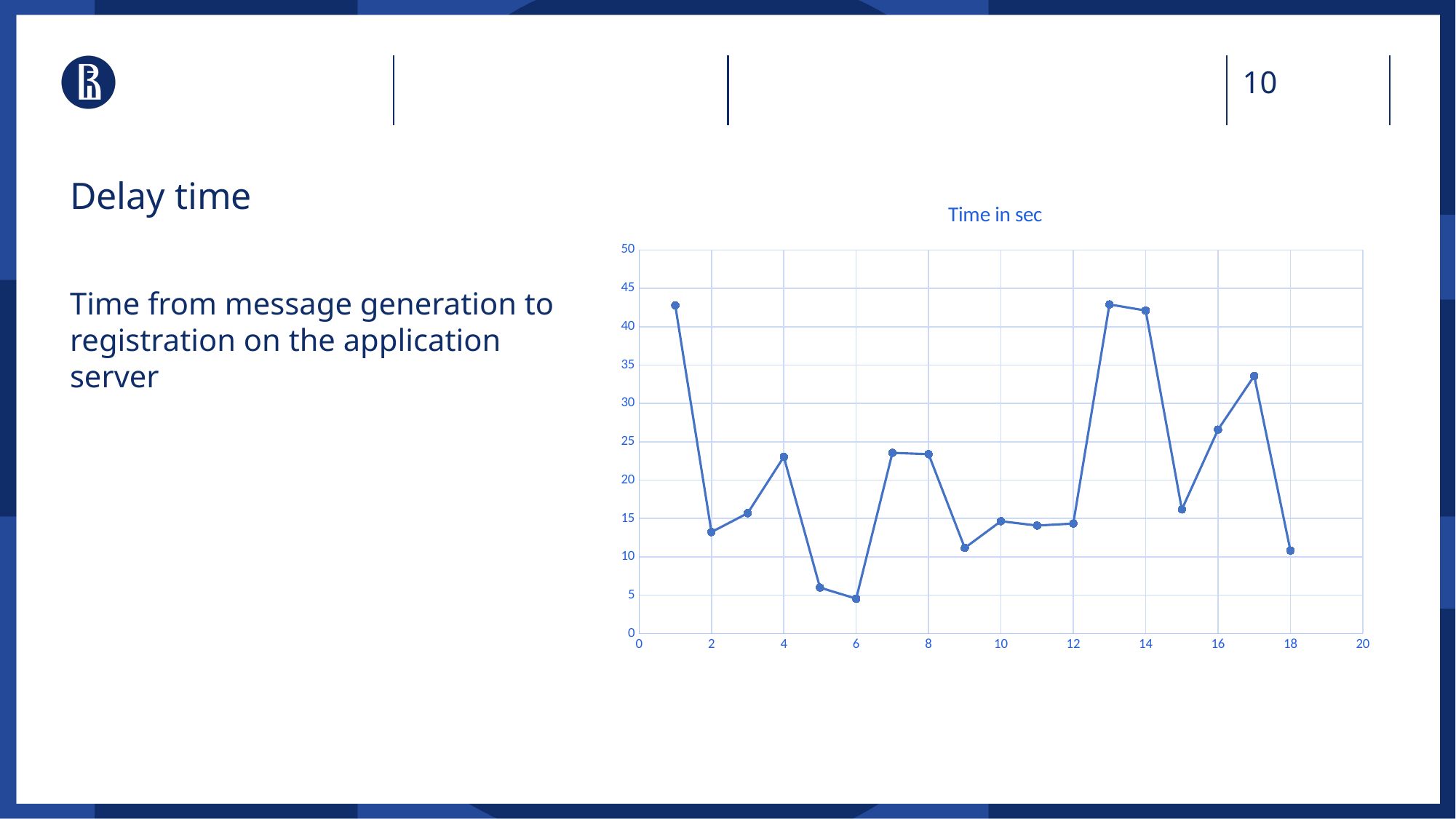
Is the value at x = 4 greater or less than 20? greater How many data points are plotted on the chart? 18 Which is larger, the value at x = 13 or the value at x = 15? x = 13 Which x value has the lowest plotted value? 6 Is the value at x = 17 greater or less than 30? greater Is the value at x = 9 greater or less than 15? less What is the title of the chart? Time in sec Between x = 15 and x = 17, do the values rise or fall? rise What kind of chart is shown on the slide? line chart Which is larger, the value at x = 2 or the value at x = 4? x = 4